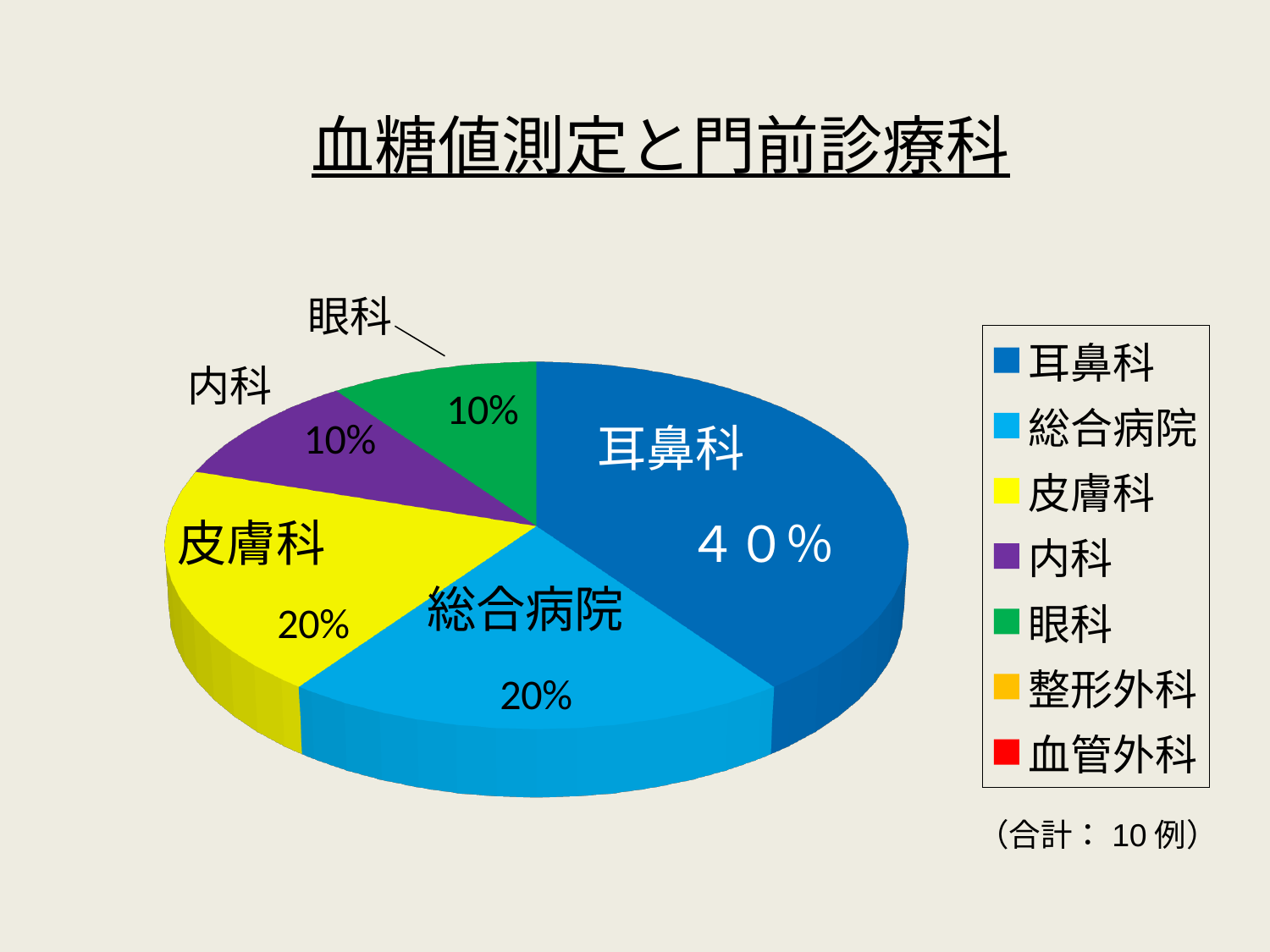
How many slices does the pie chart have? 5 What share of the pie does 耳鼻科 account for? 40% What percentage is shown for 内科? 10% What percentage is shown for 眼科? 10% What percentage is shown for 総合病院? 20% What percentage is shown for 皮膚科? 20% Which is larger, the slice for 耳鼻科 or the slice for 総合病院? 耳鼻科 What kind of chart is shown on the slide? Pie chart What is the difference in percentage points between 耳鼻科 and 皮膚科? 20 Which category has the largest slice of the pie? 耳鼻科 How many entries does the legend list? 7 Which is larger, the slice for 皮膚科 or the slice for 眼科? 皮膚科